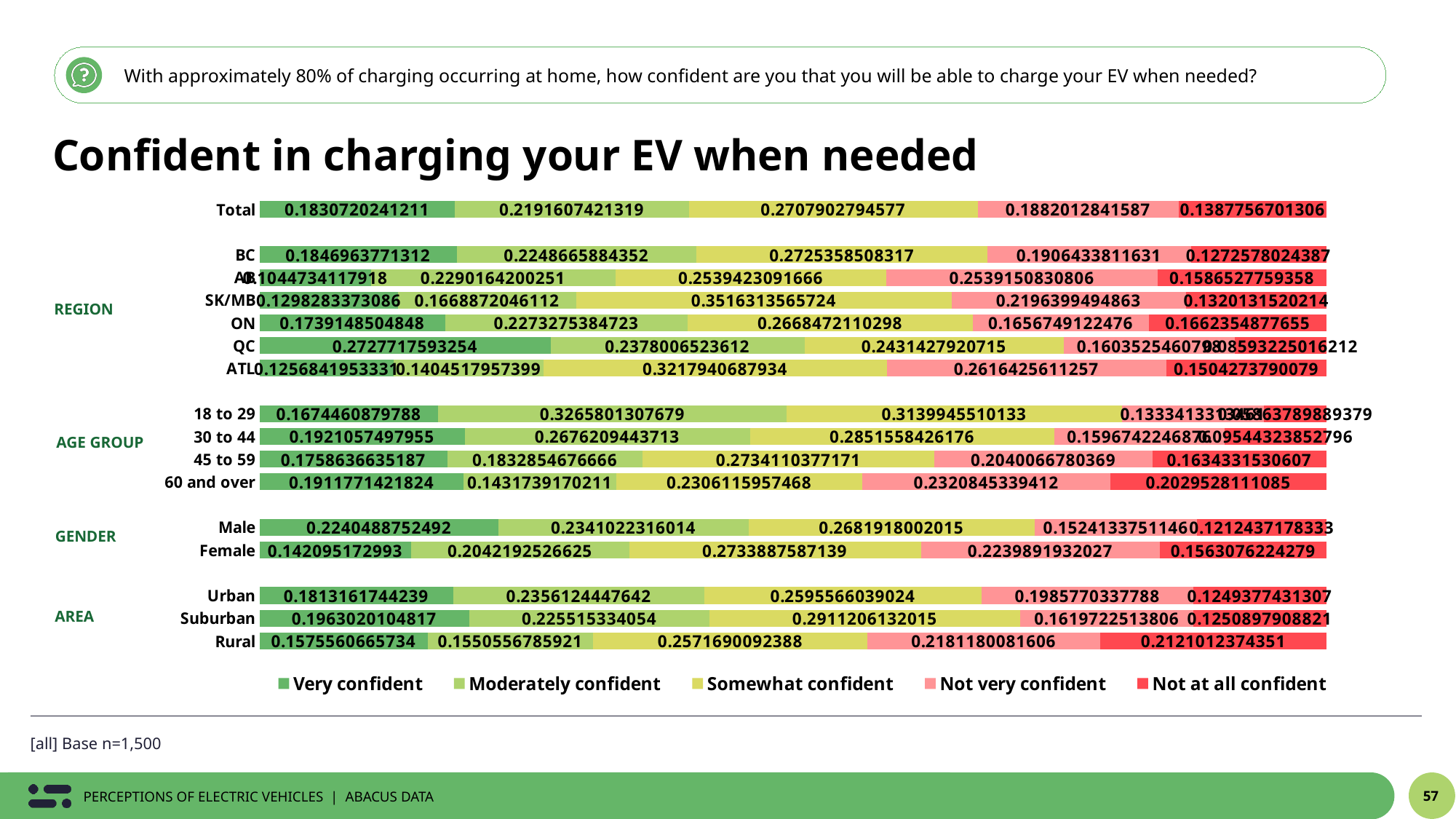
What is the difference between the Somewhat confident and Very confident values for the Total bar? 0.0877182553366 How many series does the legend list? 5 What kind of chart is shown on the slide? Stacked bar chart Among the regions (BC, AB, SK/MB, ON, QC, ATL), which has the highest Very confident value? QC What is the Not at all confident value for Rural? 0.2121012374351 What is the Somewhat confident value for SK/MB? 0.3516313565724 What is the Very confident value for the Total bar? 0.1830720241211 Among the areas (Urban, Suburban, Rural), which has the highest Not at all confident value? Rural How many category bars are plotted in the chart (including Total)? 16 Which legend entry is shown in the darkest red colour? Not at all confident What is the Moderately confident value for 18 to 29? 0.3265801307679 Which has the larger Very confident value, Male or Female? Male